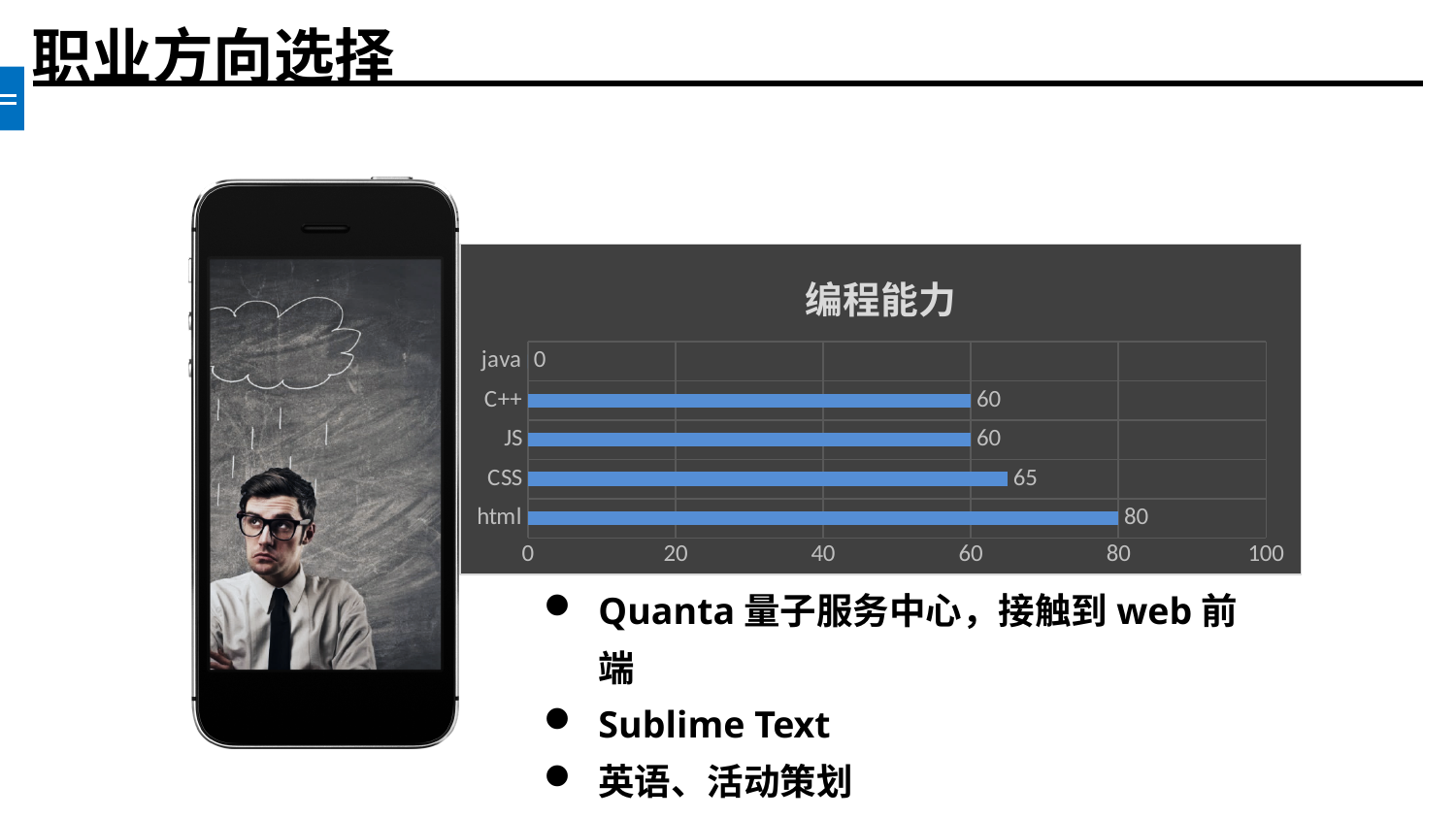
What is the value for java in the 编程能力 chart? 0 What is the difference between the values for html and CSS in the 编程能力 chart? 15 Which category has the highest value in the 编程能力 chart? html What is the value for CSS in the 编程能力 chart? 65 Which is larger in the 编程能力 chart, the value for CSS or the value for JS? CSS What kind of chart is the 编程能力 chart? bar chart Which category has the lowest value in the 编程能力 chart? java What is the maximum value shown on the horizontal axis of the 编程能力 chart? 100 Is the value for html in the 编程能力 chart greater or less than 60? greater What is the title of the chart on the slide? 编程能力 What is the value for html in the 编程能力 chart? 80 How many categories are shown in the 编程能力 chart? 5